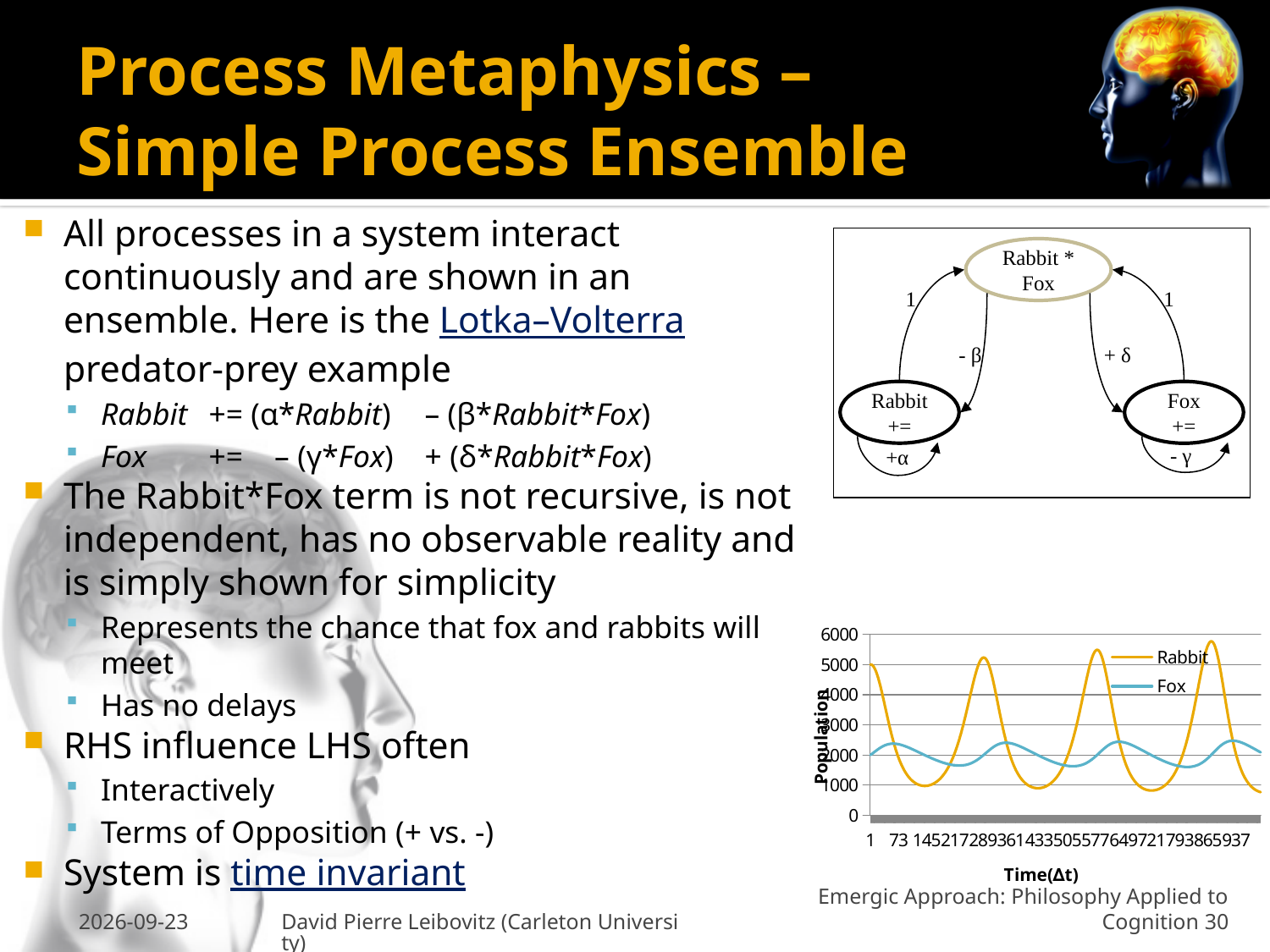
What is the label of the horizontal axis of the line chart? Time(Δt) How many series does the legend of the Population vs Time chart list? 2 In the line chart, which series reaches the higher peak values, Rabbit or Fox? Rabbit Do the Rabbit and Fox series in the line chart rise steadily, fall steadily, or oscillate over time? oscillate In the line chart, are the peak values of the Rabbit series greater or less than 5000? greater What kind of chart is shown at the bottom right of the slide? line chart What is the label of the vertical axis of the line chart? Population What are the two series named in the legend of the line chart? Rabbit and Fox How many tick labels are shown along the horizontal axis of the line chart? 14 In the line chart, are the lowest values of the Fox series greater or less than 1000? greater In the line chart, are the peak values of the Fox series greater or less than 3000? less